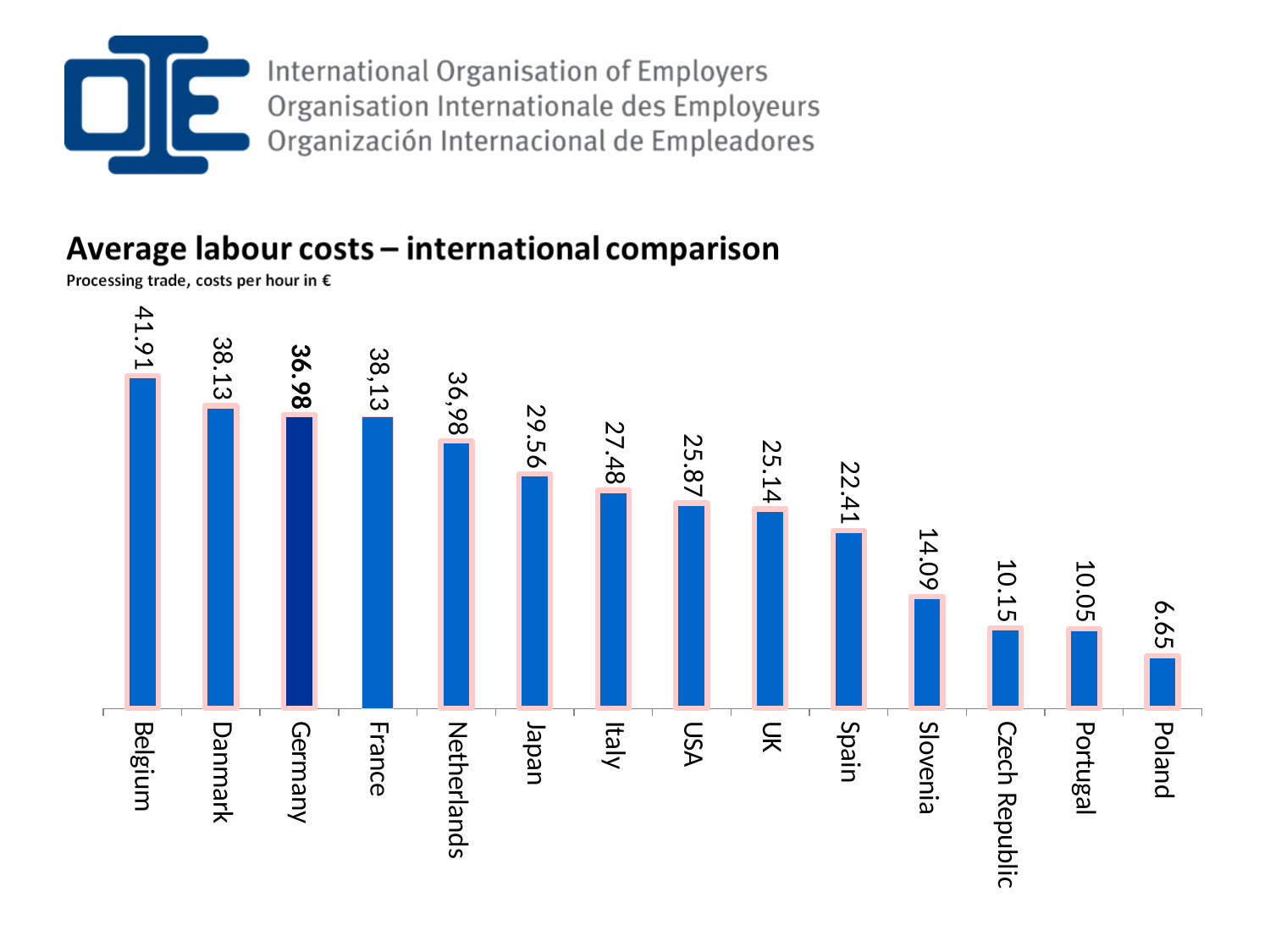
Which has the higher value, Italy or USA? Italy What is the average labour cost per hour shown for Belgium? 41.91 What value is shown for Poland? 6.65 How many countries are shown in the chart? 14 What value is shown for Japan? 29.56 What kind of chart is shown on the slide? Bar chart What value is shown for Slovenia? 14.09 Which country has the highest average labour cost in the chart? Belgium What is the difference between the values for Spain and Slovenia? 8.32 What is the difference between the values for Belgium and Poland? 35.26 Which country's bar is shown in a darker blue than the others? Germany Which country has the lowest average labour cost in the chart? Poland